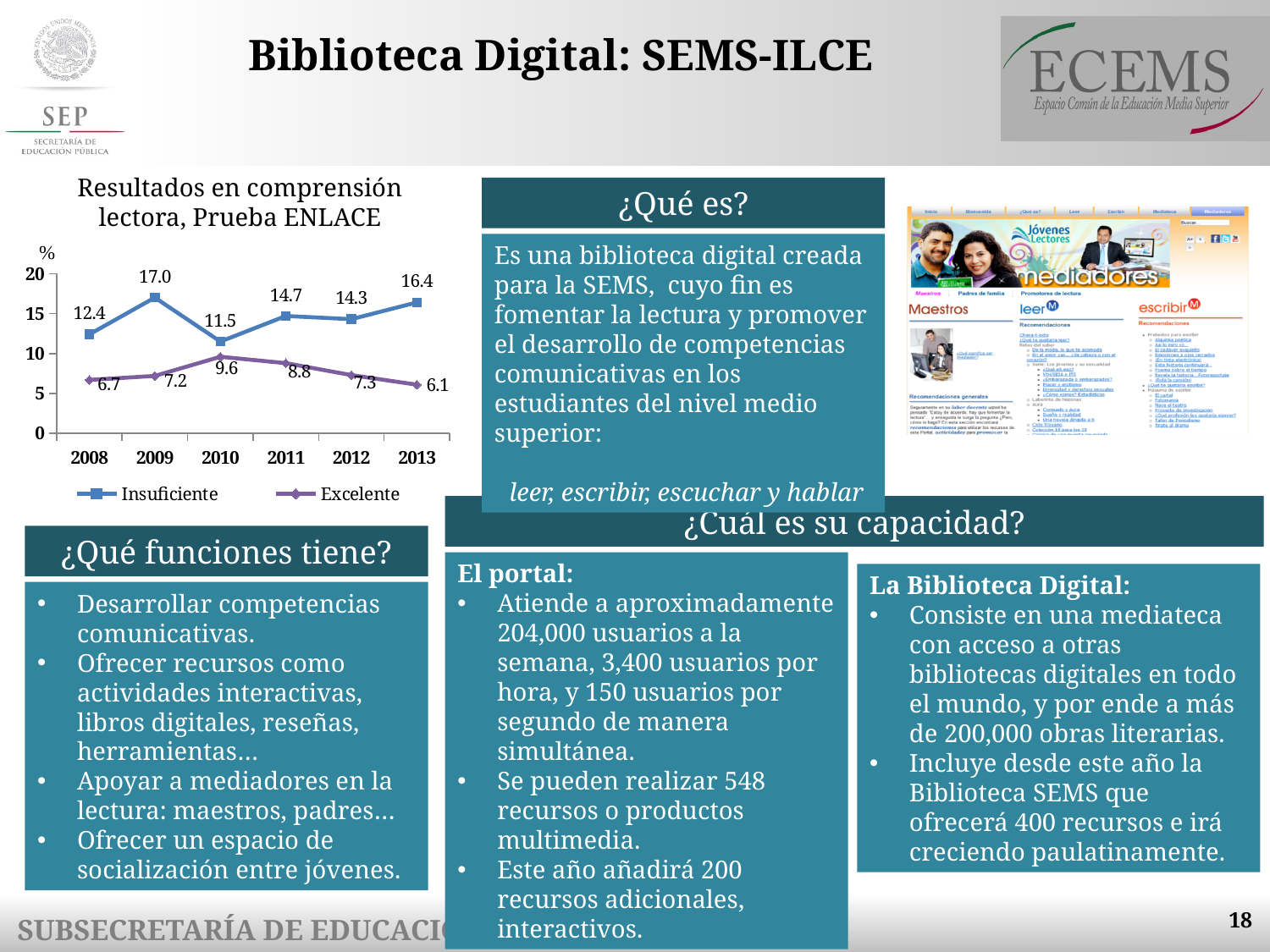
What is the difference between Insuficiente and Excelente in 2008? 5.7 How many series does the legend list? 2 Is the value for Insuficiente in 2010 greater or less than 10? greater What is the value for Excelente in 2010? 9.6 In which year is the Insuficiente series highest? 2009 In which year is the Excelente series lowest? 2013 What is the value for Insuficiente in 2013? 16.4 What is the title of the chart? Resultados en comprensión lectora, Prueba ENLACE What kind of chart is shown? Line chart Which is larger in 2011, Insuficiente or Excelente? Insuficiente What is the value for Insuficiente in 2009? 17.0 How many years are shown on the x axis? 6